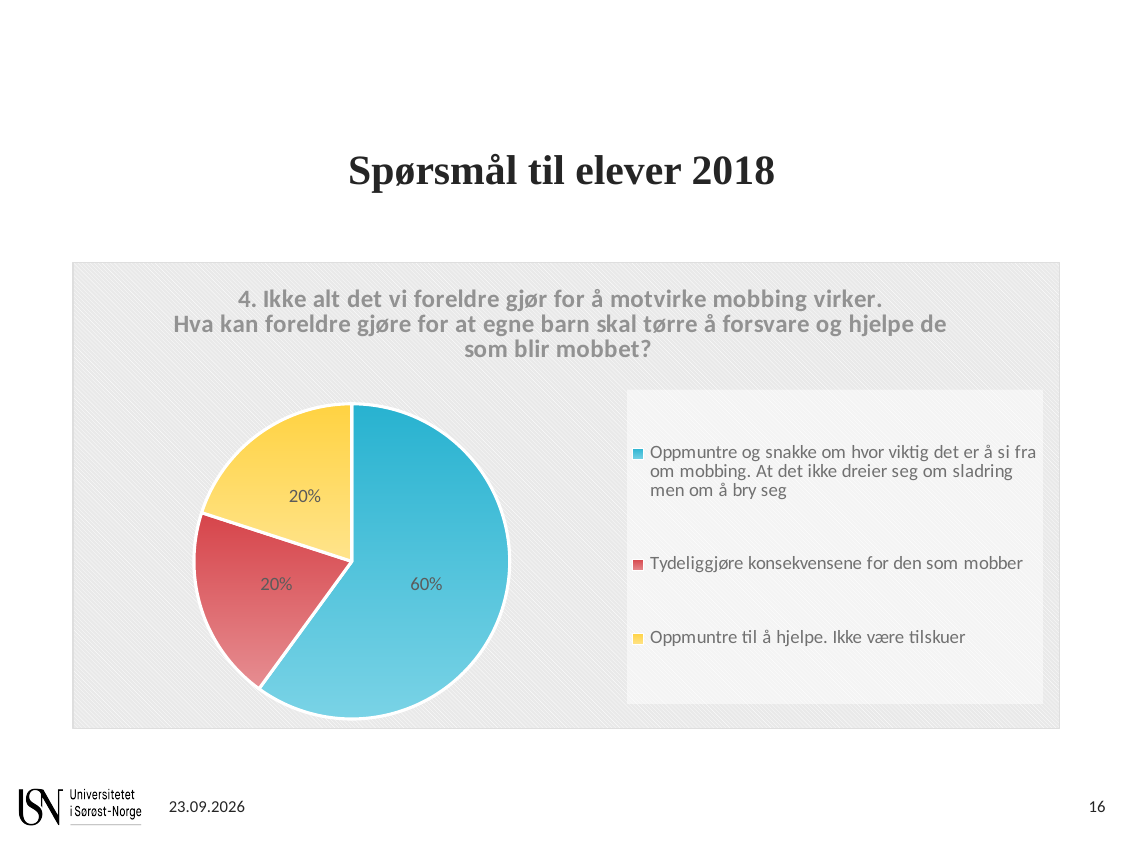
How many slices does the pie chart have? 3 What is the value shown for 'Tydeliggjøre konsekvensene for den som mobber'? 20% What is the title of the slide? Spørsmål til elever 2018 What is the value shown for 'Oppmuntre til å hjelpe. Ikke være tilskuer'? 20% What colour is the slice for 'Tydeliggjøre konsekvensene for den som mobber'? red Which category has the largest slice of the pie? Oppmuntre og snakke om hvor viktig det er å si fra om mobbing. At det ikke dreier seg om sladring men om å bry seg What kind of chart is shown on the slide? pie chart Which is larger: the slice for 'Oppmuntre og snakke om hvor viktig det er å si fra om mobbing' or the slice for 'Tydeliggjøre konsekvensene for den som mobber'? Oppmuntre og snakke om hvor viktig det er å si fra om mobbing What share of the pie is 'Oppmuntre og snakke om hvor viktig det er å si fra om mobbing. At det ikke dreier seg om sladring men om å bry seg'? 60% What is the difference in percentage points between the largest slice (60%) and the slice for 'Oppmuntre til å hjelpe. Ikke være tilskuer'? 40 percentage points How many entries does the legend of the pie chart list? 3